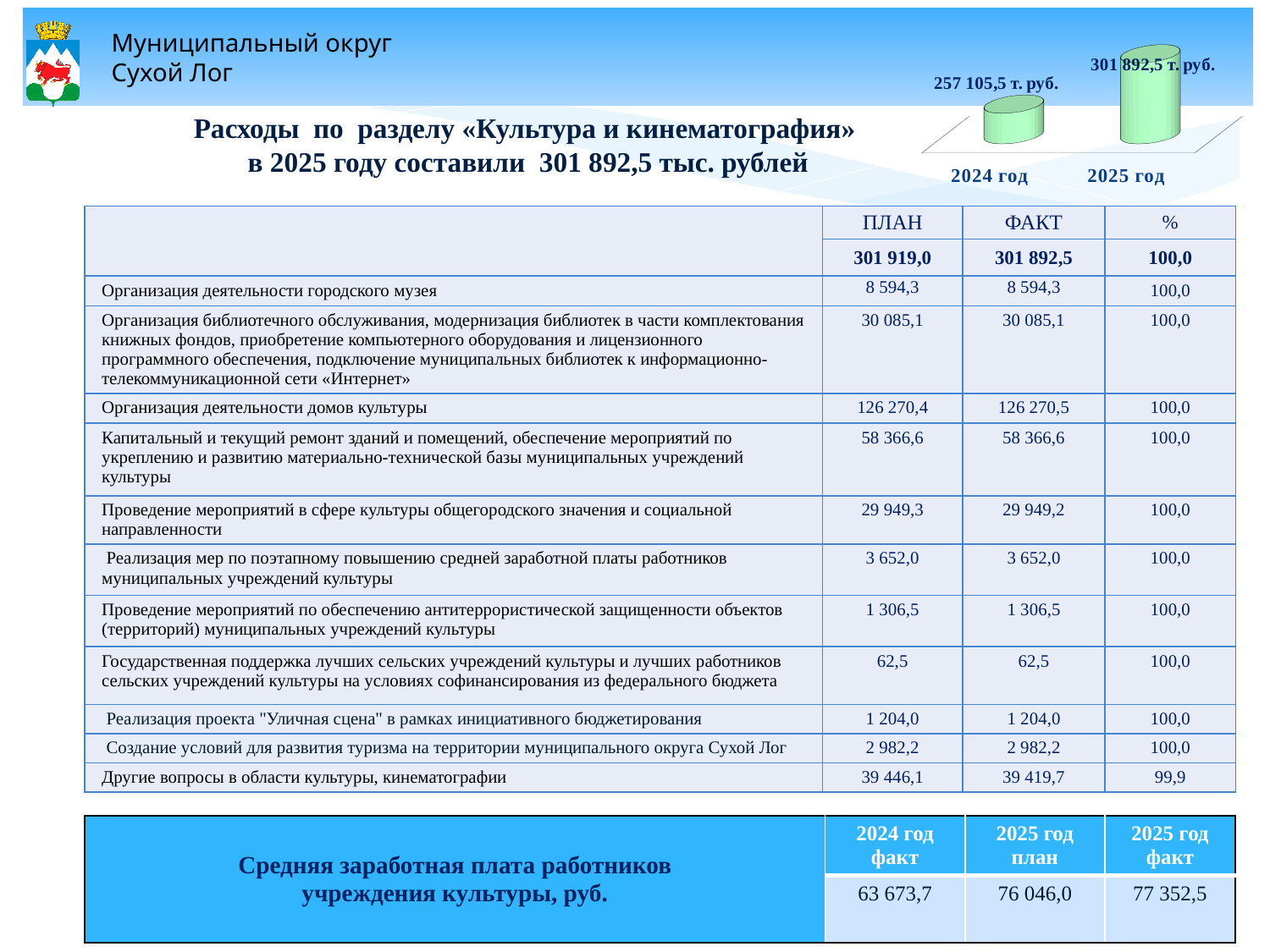
Which year has the lower value in the chart? 2024 год Do the values in the chart rise or fall from 2024 год to 2025 год? rise What is the value shown for 2024 год in the chart? 257 105,5 т. руб. What are the category labels on the x axis of the chart? 2024 год, 2025 год What is the value shown for 2025 год in the chart? 301 892,5 т. руб. What colour are the bars in the chart? green How many bars are plotted in the chart? 2 Which year has the higher value in the chart? 2025 год Is the value for 2024 год larger or smaller than the value for 2025 год in the chart? smaller By how much does the 2025 год value exceed the 2024 год value in the chart? 44 787,0 т. руб. What kind of chart is shown in the top right of the slide? bar chart